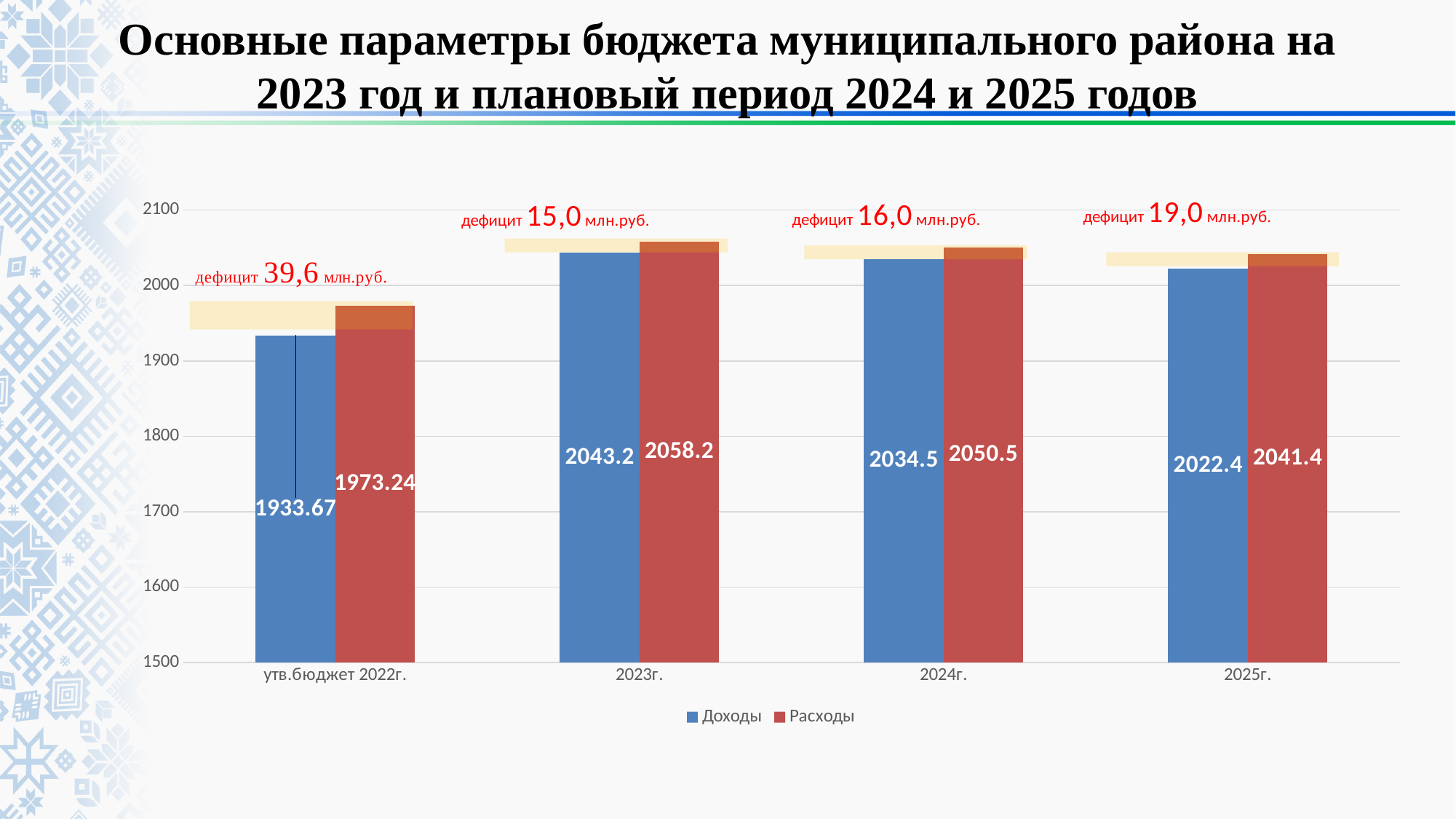
What is the value of Расходы for 2025г.? 2041.4 What is the value of Расходы for утв.бюджет 2022г.? 1973.24 Is the Доходы value for утв.бюджет 2022г. greater or less than 2000? less Which category has the lowest Расходы value? утв.бюджет 2022г. What kind of chart is shown on the slide? bar chart Which category has the highest Доходы value? 2023г. What is the value of Доходы for 2023г.? 2043.2 Which is larger for 2025г., Доходы or Расходы? Расходы How many series does the legend list? 2 What deficit (дефицит) is annotated above the 2023г. bars? 15,0 млн.руб. How many categories are shown on the x axis? 4 What is the difference between Расходы and Доходы for 2024г.? 16.0